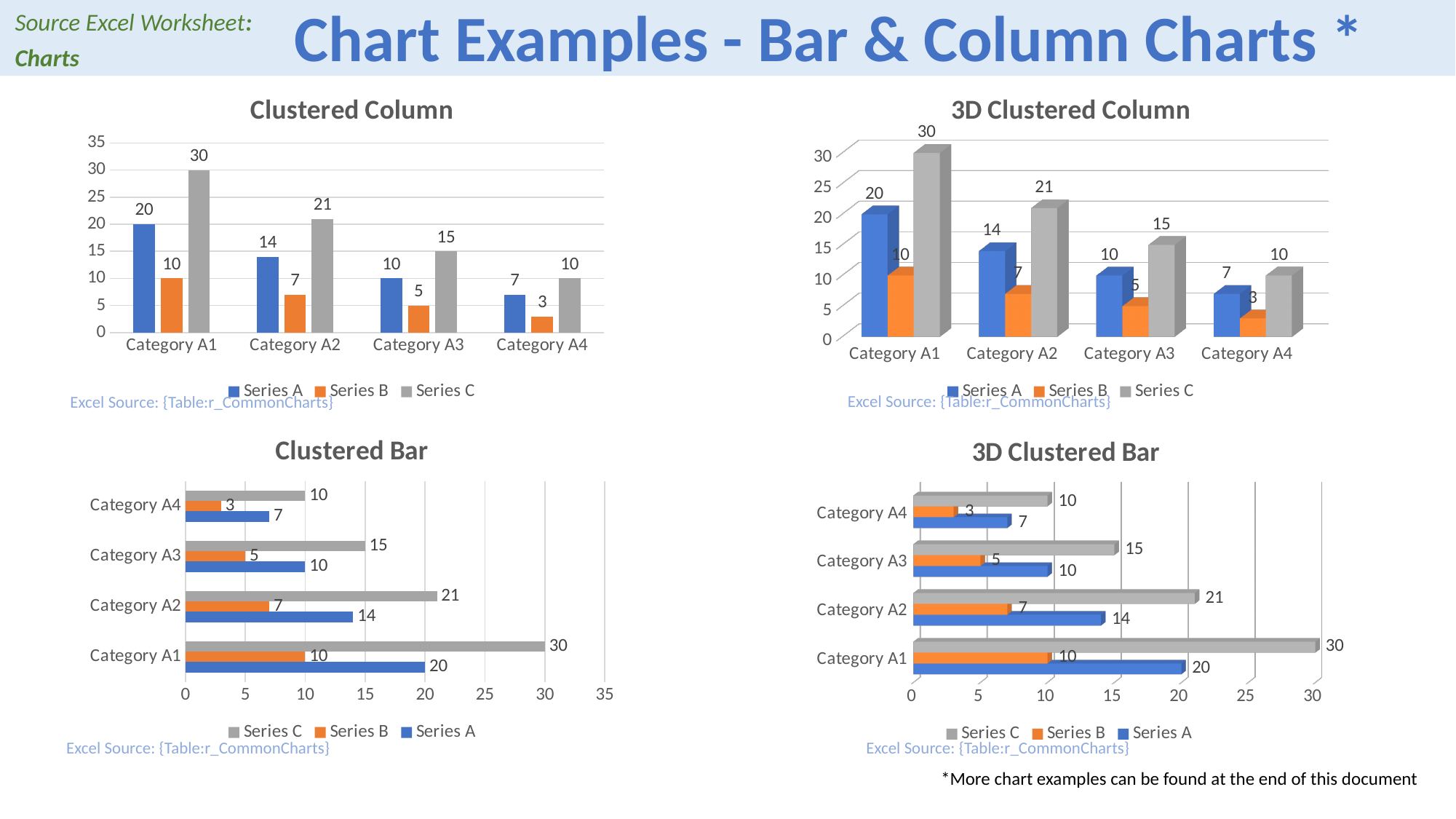
In the 3D Clustered Bar chart, what is the difference between Series A and Series B for Category A1? 10 In the Clustered Bar chart, how many categories are shown? 4 In the Clustered Bar chart, is the Series A value for Category A1 larger or the Series C value for Category A2? Series C for Category A2 In the 3D Clustered Column chart, which category has the lowest Series A value? Category A4 In the 3D Clustered Column chart, what is the value of Series B for Category A3? 5 In the Clustered Column chart, what is the value of Series A for Category A1? 20 In the 3D Clustered Bar chart, what is the value of Series B for Category A4? 3 In the Clustered Column chart, do the Series A values rise or fall from Category A1 to Category A4? fall In the Clustered Bar chart, what is the value of Series C for Category A3? 15 In the Clustered Column chart, which category has the highest Series C value? Category A1 In the Clustered Column chart, what is the difference between Series C and Series B for Category A2? 14 In the 3D Clustered Column chart, how many series does the legend list? 3